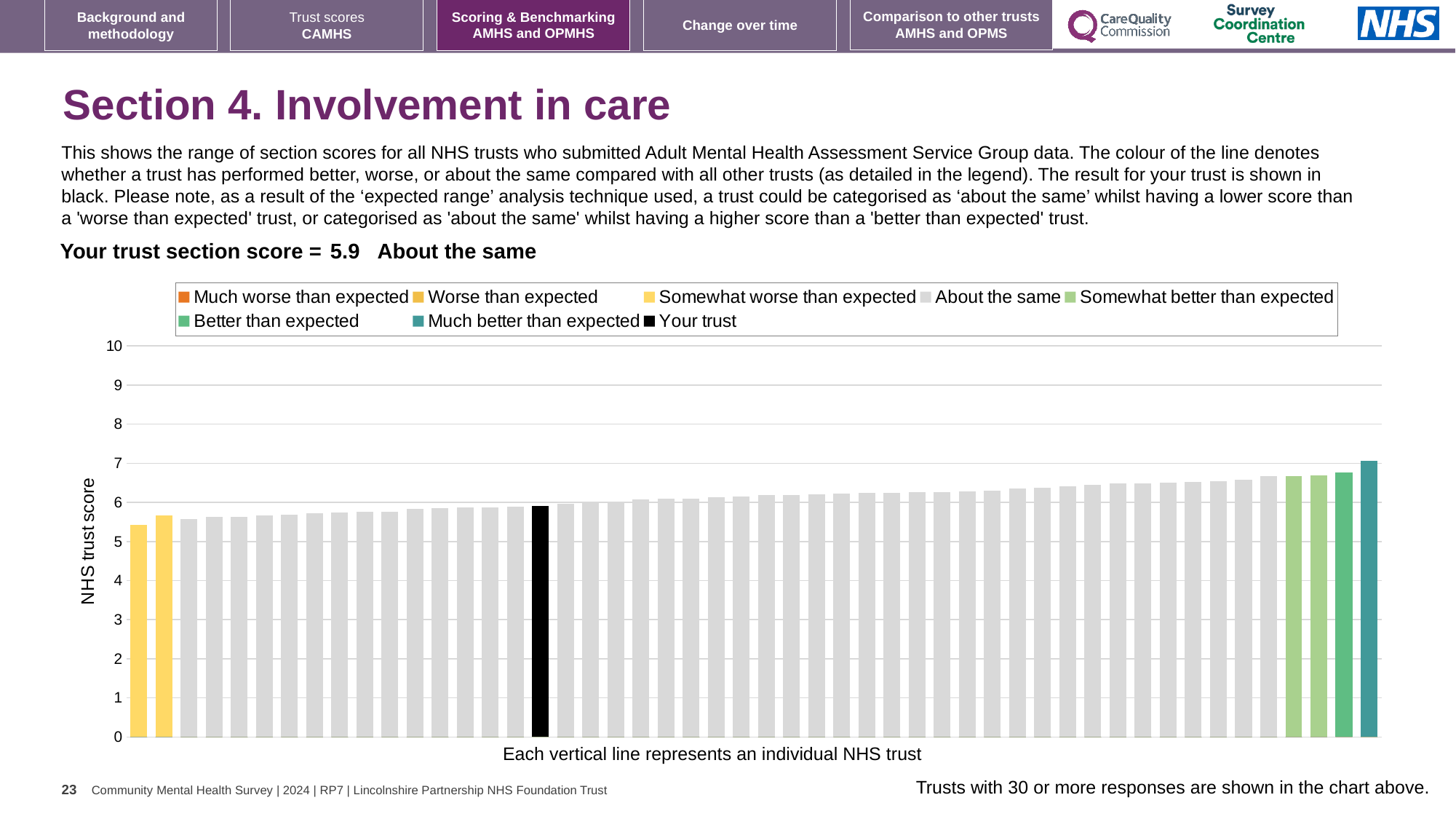
What colour is the bar representing your trust? black What kind of chart is shown on the slide? bar chart Is the value of the lowest bar in the chart greater or less than 6? less Is the value for your trust's bar greater or less than 6? less What is the section score for your trust shown on the slide? 5.9 How many entries does the chart legend list? 8 Is the value for your trust's bar greater or less than 5? greater Do the bar values rise or fall from left to right across the chart? rise Which category is your trust's section score placed in? About the same What is the label on the vertical axis of the chart? NHS trust score